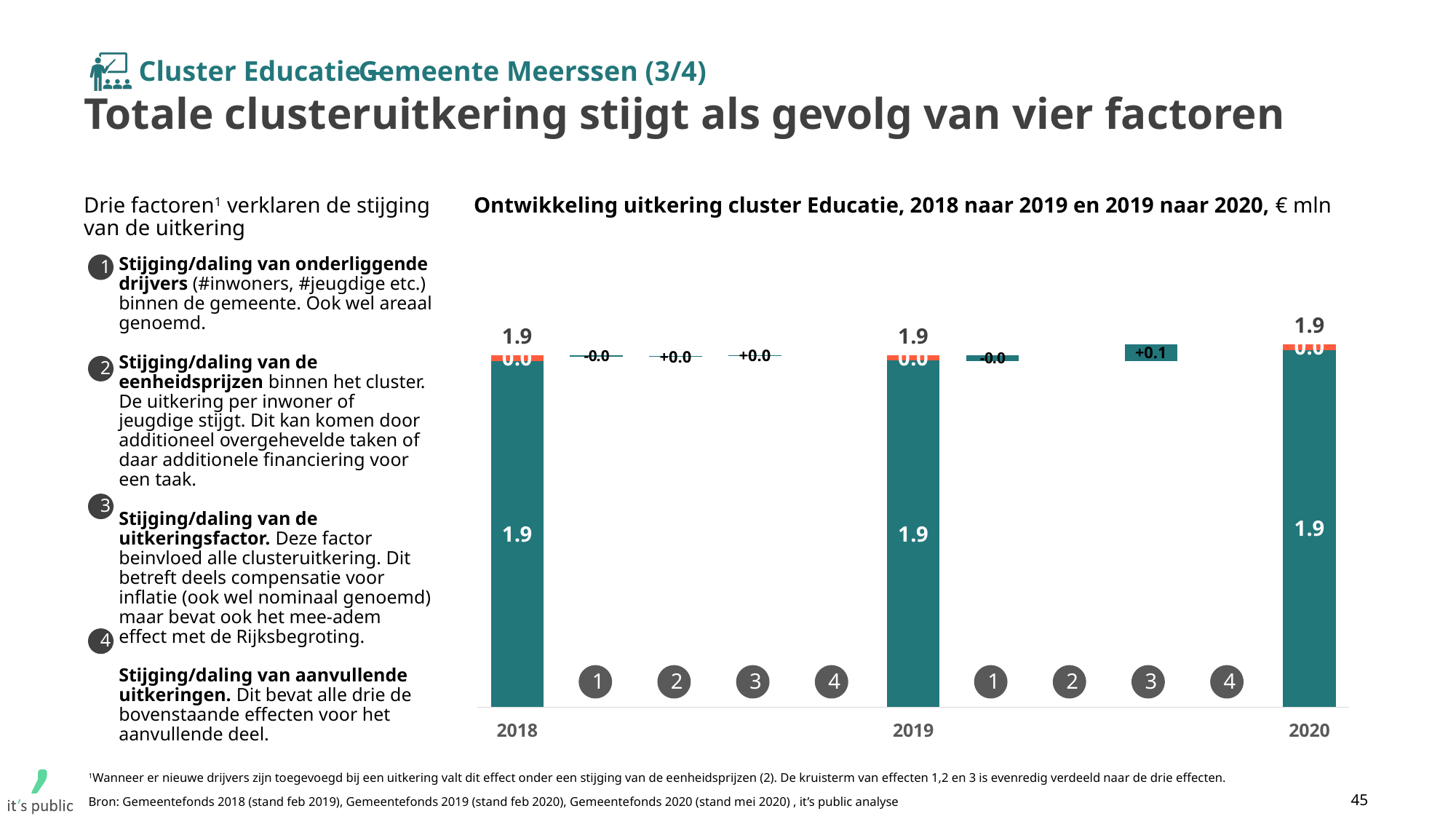
What is the total uitkering for cluster Educatie in 2019 shown above the bar? 1.9 What is the value of the effect labelled 2 between 2018 and 2019? +0.0 What kind of chart is used to show the development of the uitkering? Bar chart (waterfall) What is the total uitkering for cluster Educatie in 2018 shown above the bar? 1.9 What is the value of the effect labelled 3 (uitkeringsfactor) between 2019 and 2020? +0.1 How many year totals (2018, 2019, 2020) are shown as full bars in the chart? 3 What is the value of the teal (main) segment of the 2020 bar? 1.9 What is the value of the effect labelled 1 between 2019 and 2020? -0.0 Does the total uitkering rise, fall or stay flat from 2018 to 2020 according to the labels? Stays flat at 1.9 Which effect between 2019 and 2020 has the largest labelled value? Effect 3 (+0.1) What is the total uitkering for cluster Educatie in 2020 shown above the bar? 1.9 In what unit are the values in the chart expressed, according to the chart title? € mln